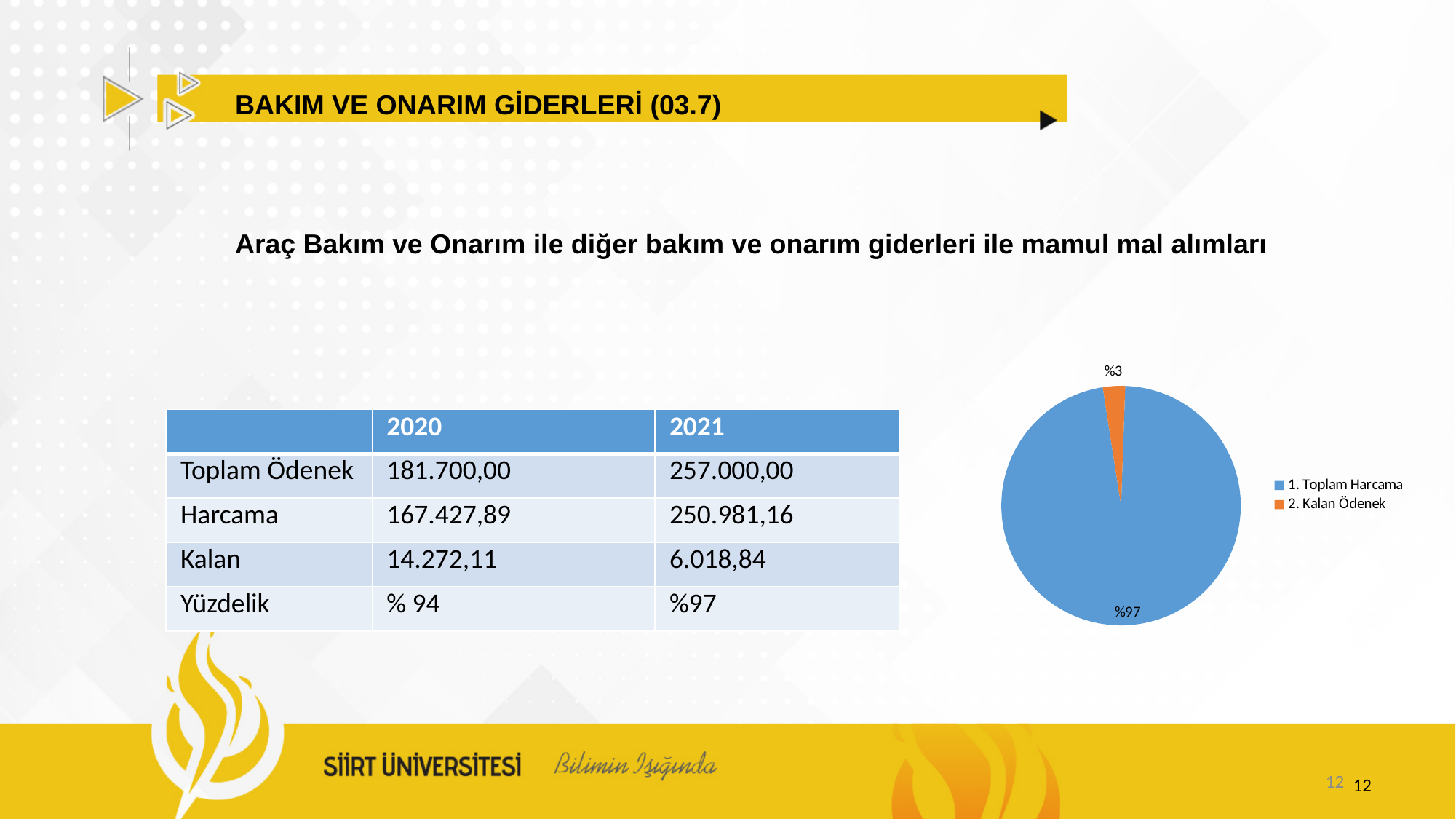
How many slices does the pie chart have? 2 Which slice of the pie chart is the largest? 1. Toplam Harcama Which slice of the pie chart is the smallest? 2. Kalan Ödenek How many entries does the pie chart's legend list? 2 What is the difference in percentage points between the '1. Toplam Harcama' and '2. Kalan Ödenek' slices of the pie chart? 94 What share of the pie chart does '2. Kalan Ödenek' represent? %3 What colour is the '1. Toplam Harcama' slice in the pie chart? blue What colour is the '2. Kalan Ödenek' slice in the pie chart? orange What kind of chart is shown on the slide? pie chart What share of the pie chart does '1. Toplam Harcama' represent? %97 In the pie chart, which is larger: '1. Toplam Harcama' or '2. Kalan Ödenek'? 1. Toplam Harcama